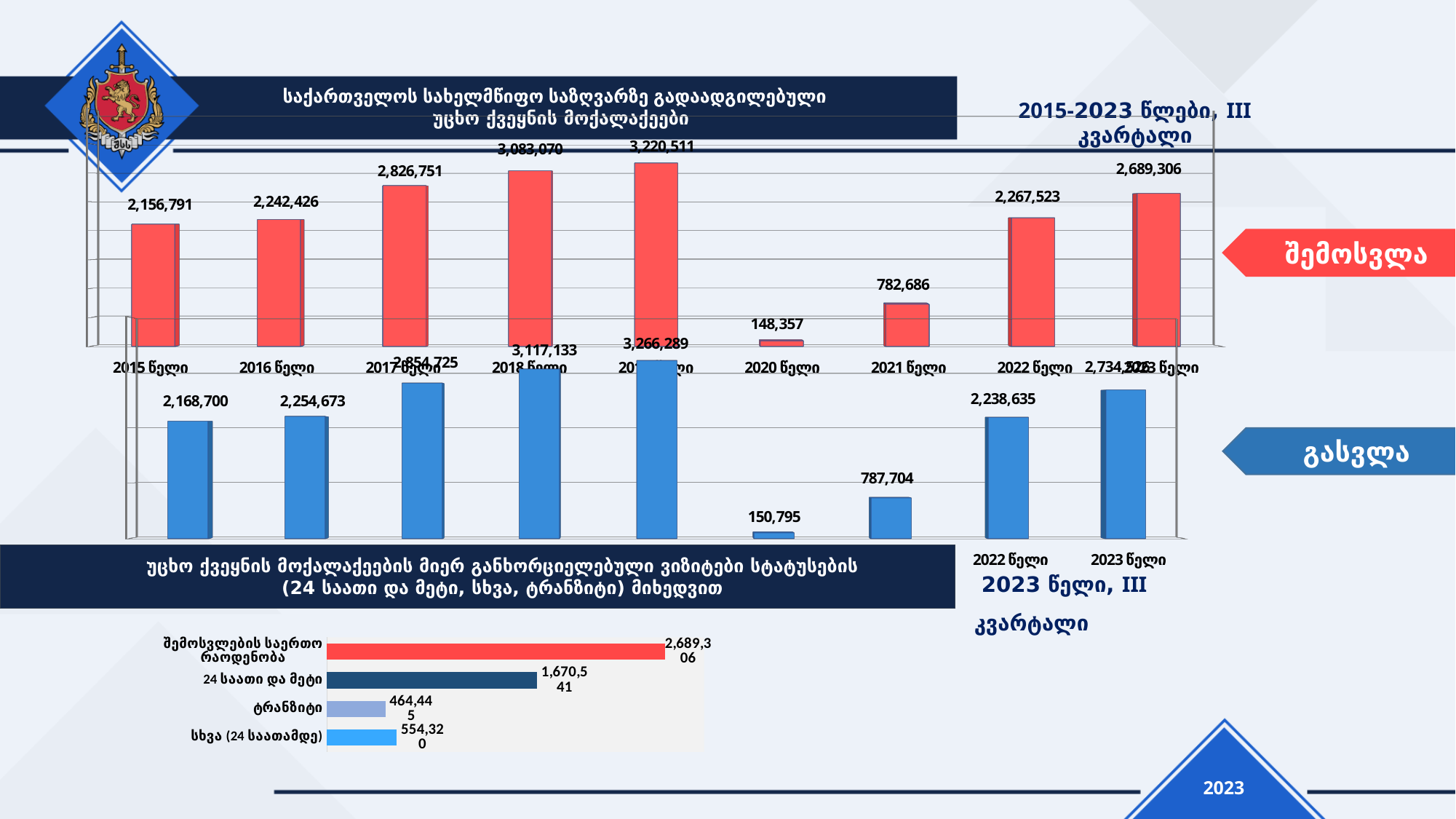
In the bottom horizontal bar chart, which is larger, ტრანზიტი or სხვა (24 საათამდე)? სხვა (24 საათამდე) What kind of chart is the bottom chart on the slide? Bar chart In the middle blue bar chart (გასვლა), what is the value for 2018 წელი? 3,117,133 In the top red bar chart (შემოსვლა), what is the value for 2019 წელი? 3,220,511 In the bottom horizontal bar chart, what is the value for 24 საათი და მეტი? 1,670,541 In the middle blue bar chart (გასვლა), what is the value for 2021 წელი? 787,704 In the top red bar chart (შემოსვლა), how many years are shown? 9 In the top red bar chart (შემოსვლა), what is the value for 2020 წელი? 148,357 In the top red bar chart (შემოსვლა), which year has the highest value? 2019 წელი In the top red bar chart (შემოსვლა), what is the difference between the values for 2023 წელი and 2022 წელი? 421,783 In the middle blue bar chart (გასვლა), which is larger, the value for 2015 წელი or 2016 წელი? 2016 წელი In the top red bar chart (შემოსვლა), which year has the lowest value? 2020 წელი